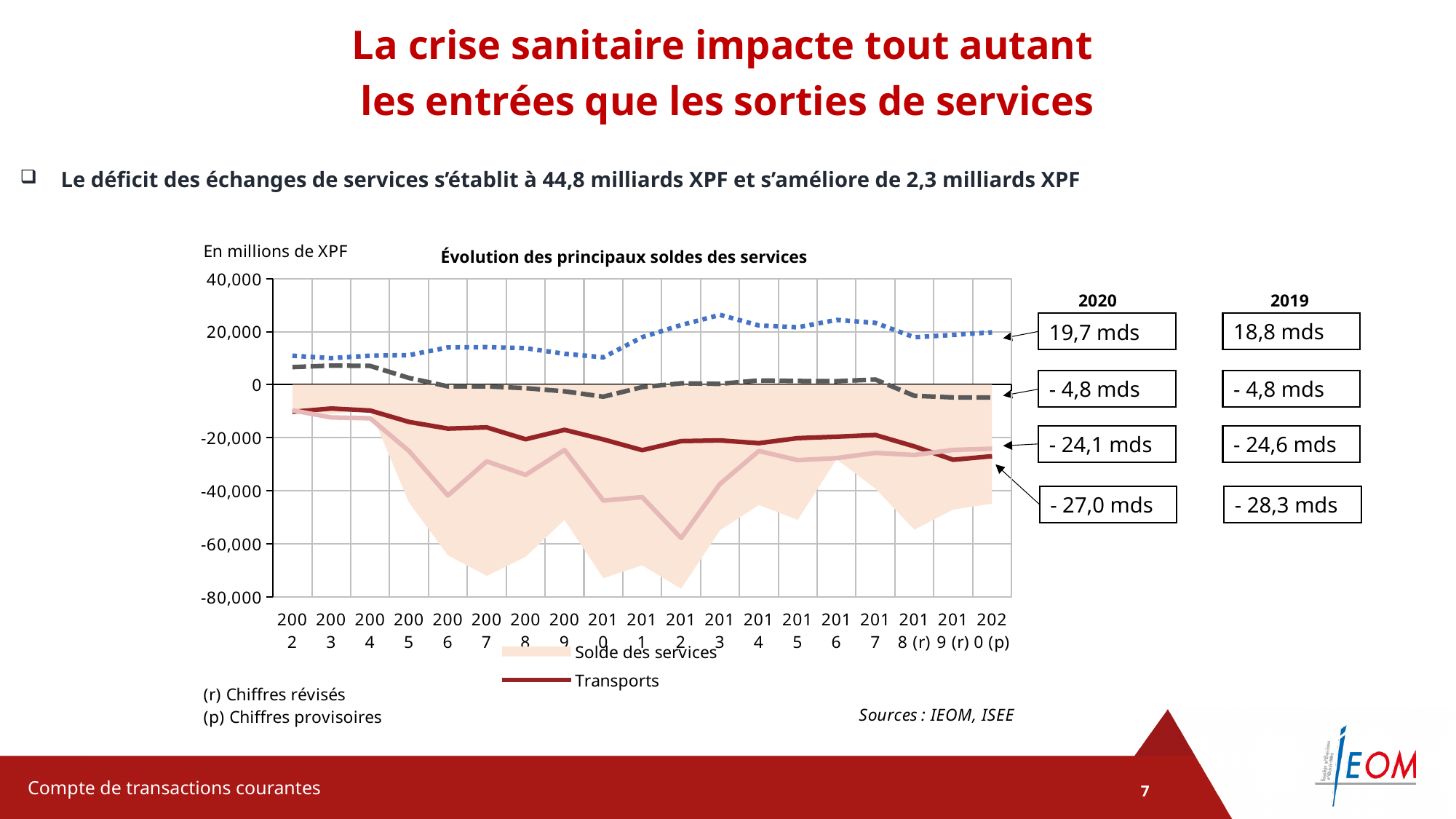
Is the value of Transports in 2020 greater or less than -20,000? less What kind of chart is shown on the slide? combination area and line chart Which is larger for Transports, the 2020 value or the 2019 value? 2020 How many years are plotted on the x axis of the chart? 19 What is the value of Transports in 2020 according to the annotation on the right of the chart? - 27,0 mds How many series are listed in the legend below the chart? 2 By how much did the Transports balance change between 2019 (- 28,3 mds) and 2020 (- 27,0 mds)? 1,3 mds What is the title of the chart? Évolution des principaux soldes des services Does the Transports line rise or fall overall from 2002 to 2020? fall Is the value of Solde des services in 2020 greater or less than -40,000? less What is the value of Transports in 2019 according to the annotation on the right of the chart? - 28,3 mds In what unit are the values on the chart expressed? En millions de XPF